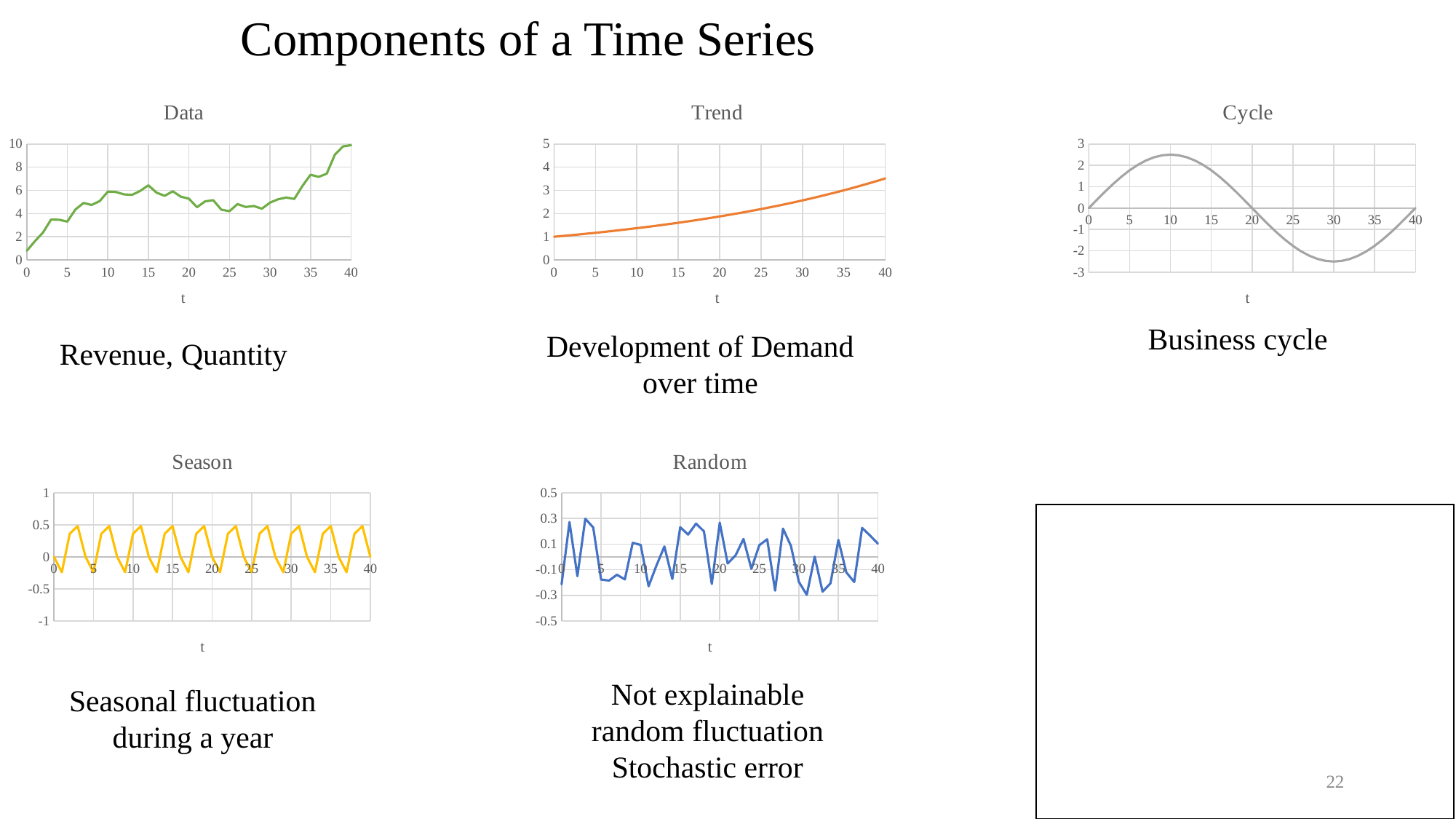
What kind of chart is the 'Data' chart? line chart In the 'Cycle' chart, is the value at t=10 greater or less than 2? greater In the 'Season' chart, are the peak values greater or less than 1? less In the 'Trend' chart, is the value at t=0 greater or less than 2? less What colour is the line in the 'Random' chart? blue In the 'Trend' chart, do the values rise or fall as t increases along the x axis? rise What is the x-axis label on the 'Season' chart? t How many charts are shown on the slide? 5